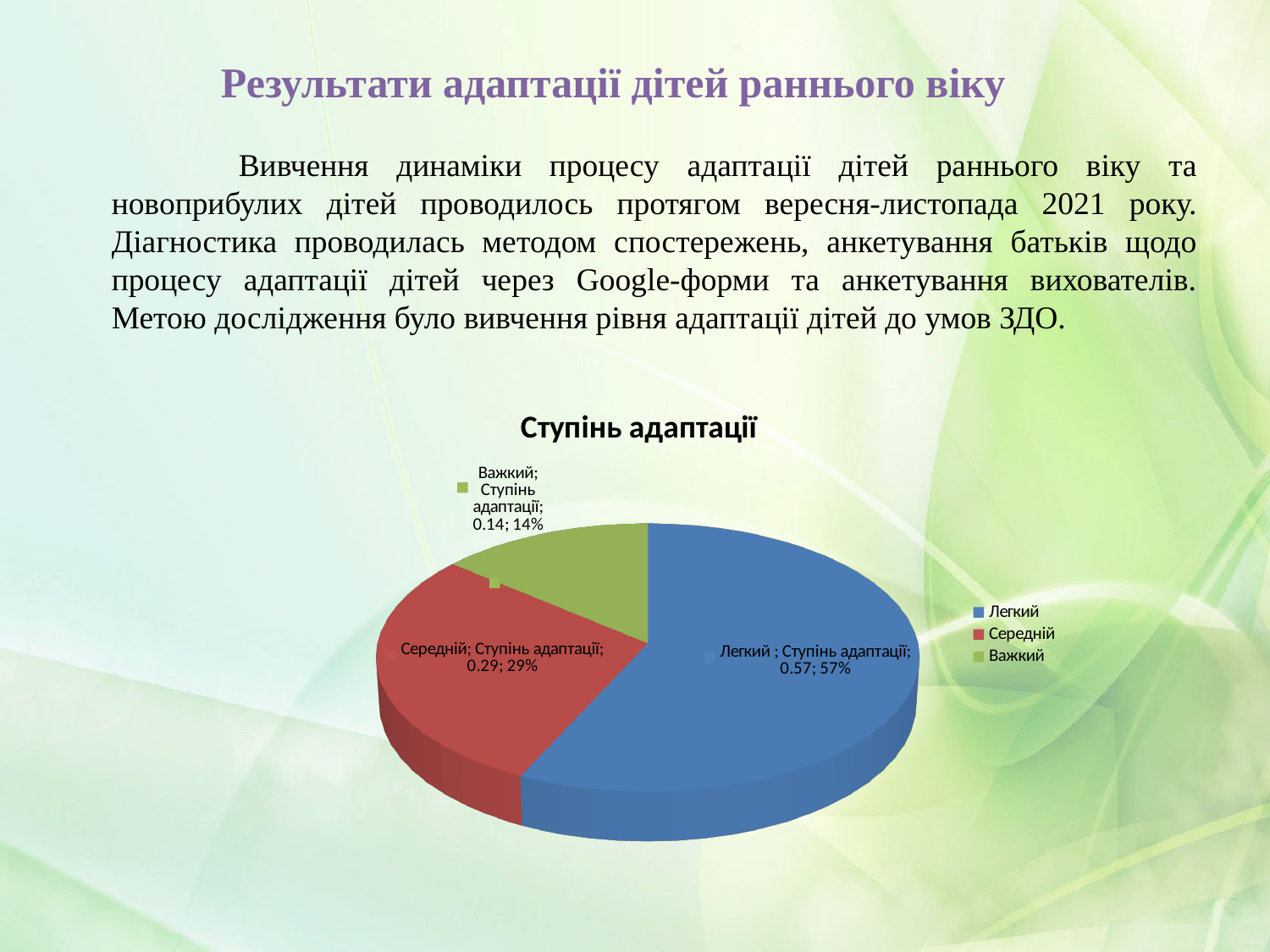
How many slices does the pie chart have? 3 What percentage share does the Середній slice have? 29% What value is printed for the Важкий slice? 0.14 What value is printed for the Легкий slice? 0.57 How many entries does the legend list? 3 What is the difference in percentage points between the Легкий and Середній slices? 28% What percentage share does the Важкий slice have? 14% Which category has the smallest slice? Важкий What percentage share does the Легкий slice have? 57% What kind of chart is shown on the slide? Pie chart Which category has the largest slice? Легкий What is the title of the chart? Ступінь адаптації